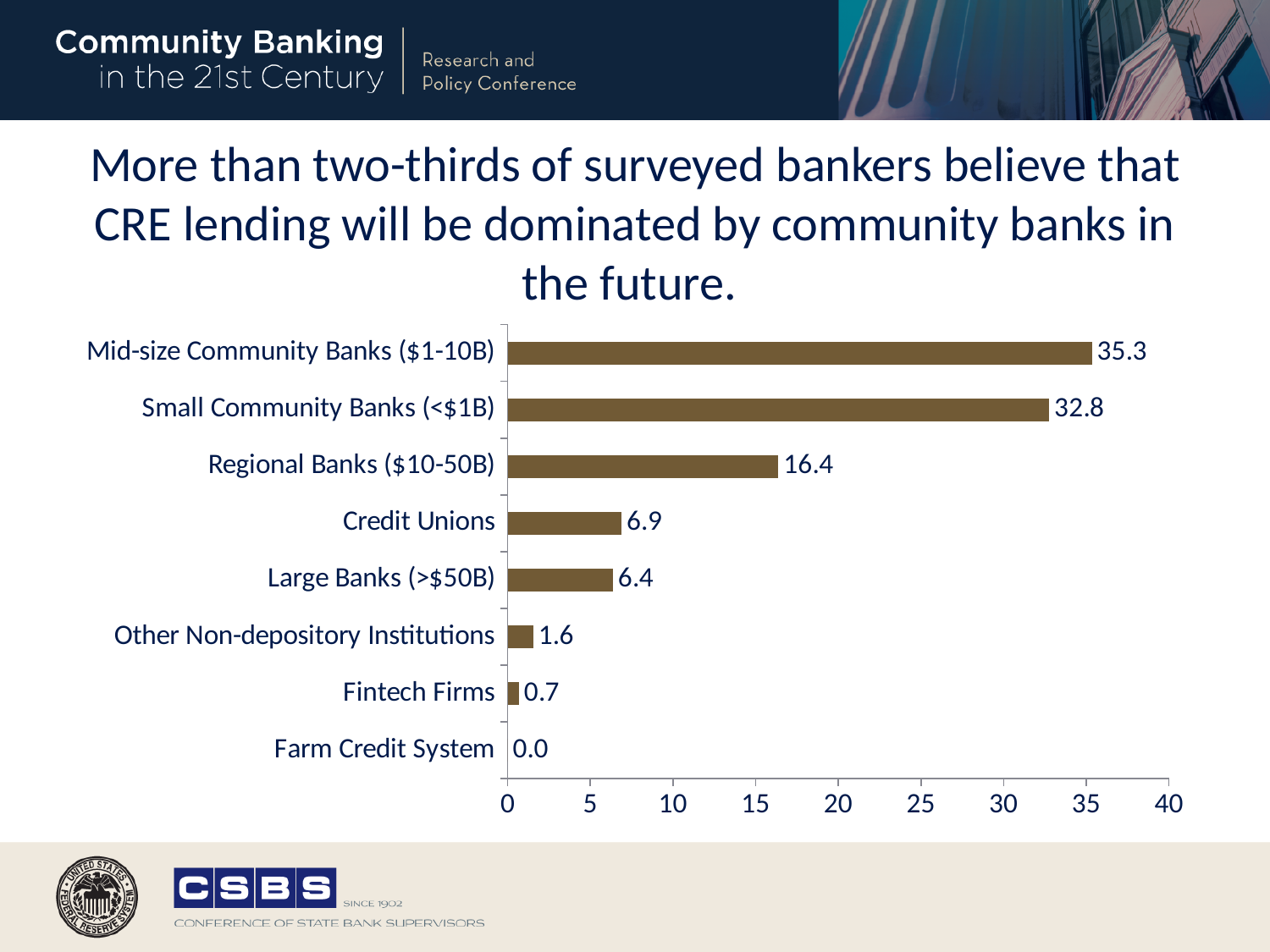
Which category has the highest value? Mid-size Community Banks ($1-10B) What is the value for Other Non-depository Institutions? 1.6 What is the value for Fintech Firms? 0.7 What is the difference between the values for Regional Banks ($10-50B) and Large Banks (>$50B)? 10.0 What kind of chart is shown on the slide? bar chart What is the value for Mid-size Community Banks ($1-10B)? 35.3 How many categories are shown in the chart? 8 Is the value for Small Community Banks (<$1B) greater or less than 30? greater What is the difference between the values for Mid-size Community Banks ($1-10B) and Small Community Banks (<$1B)? 2.5 What is the value for Regional Banks ($10-50B)? 16.4 Which is larger, the value for Credit Unions or the value for Large Banks (>$50B)? Credit Unions Which category has the lowest value? Farm Credit System